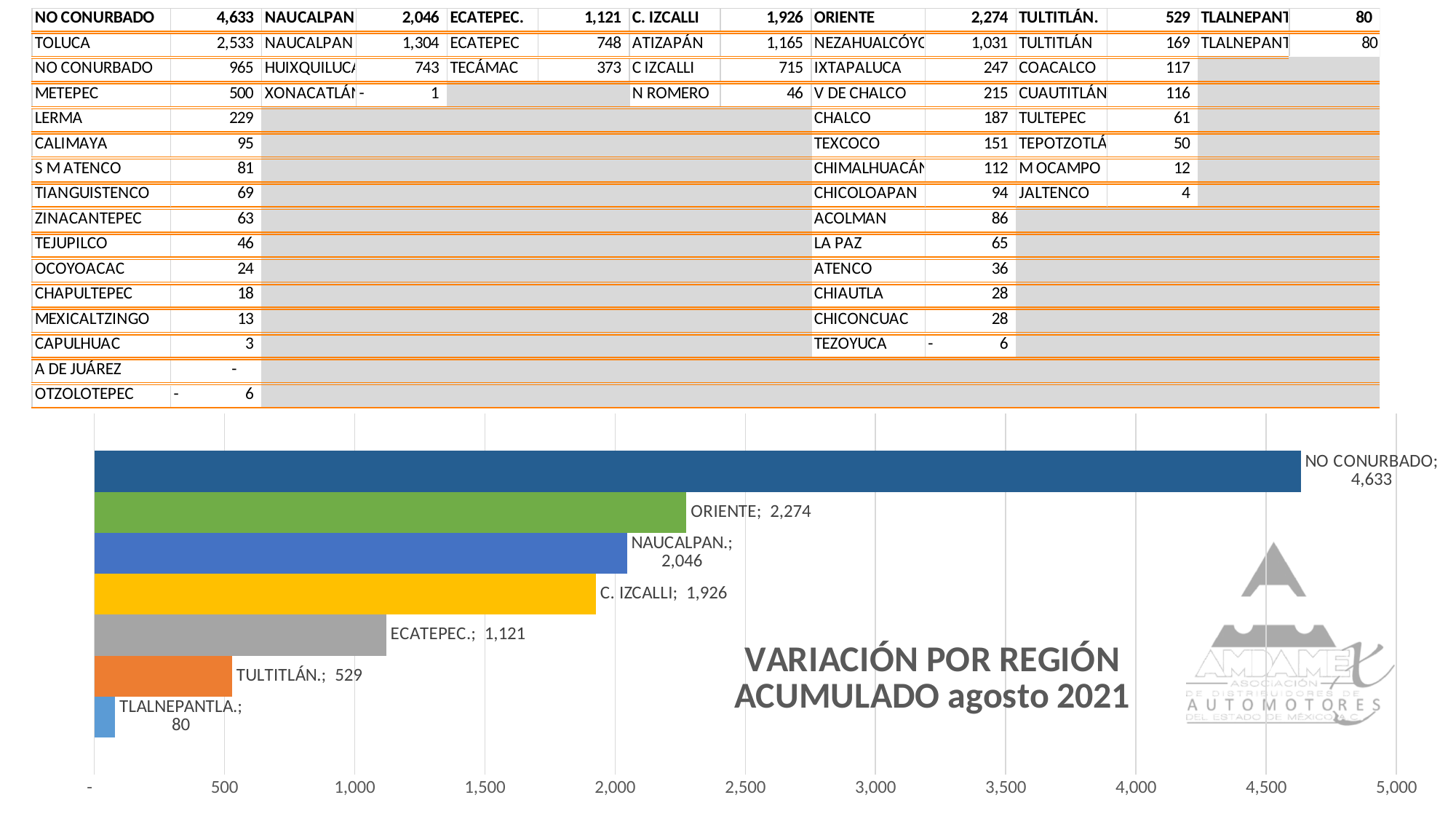
What type of chart is shown on the slide? bar chart Which region has the lowest value in the bar chart? TLALNEPANTLA. Which has a larger value in the bar chart, ORIENTE or C. IZCALLI? ORIENTE What is the title of the chart on the slide? VARIACIÓN POR REGIÓN ACUMULADO agosto 2021 What value is shown for NO CONURBADO in the bar chart? 4,633 Is the value for TULTITLÁN. in the bar chart greater or less than 1,000? less How many bars are plotted in the bar chart? 7 Which region has the highest value in the bar chart? NO CONURBADO What is the difference between the values for NAUCALPAN. and ECATEPEC. in the bar chart? 925 What value is shown for C. IZCALLI in the bar chart? 1,926 What value is shown for ORIENTE in the bar chart? 2,274 What value is shown for TLALNEPANTLA. in the bar chart? 80